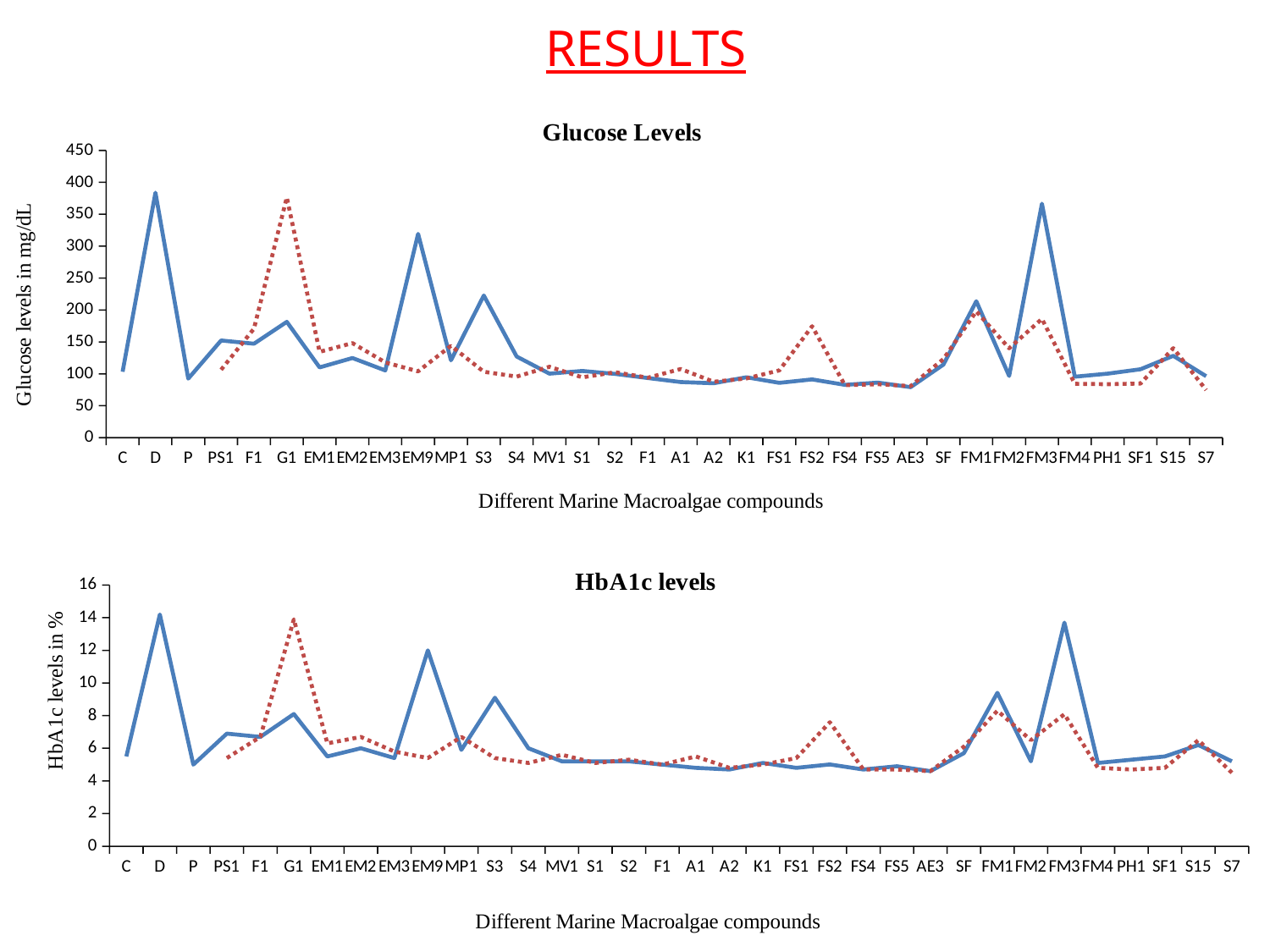
In the HbA1c levels chart, is the value of the blue solid line at D greater or less than 12? greater In the HbA1c levels chart, which has the larger blue solid line value, EM9 or S3? EM9 What kind of chart is the Glucose Levels chart? line chart In the HbA1c levels chart, is the value of the blue solid line at P greater or less than 6? less What is the y-axis label of the Glucose Levels chart? Glucose levels in mg/dL How many compound categories are shown on the x axis of the HbA1c levels chart? 34 What is the x-axis label of the HbA1c levels chart? Different Marine Macroalgae compounds In the Glucose Levels chart, is the value of the red dotted line at FS2 greater or less than 150? greater In the Glucose Levels chart, at which compound does the red dotted line reach its highest value? G1 In the Glucose Levels chart, which has the larger blue solid line value, EM9 or S3? EM9